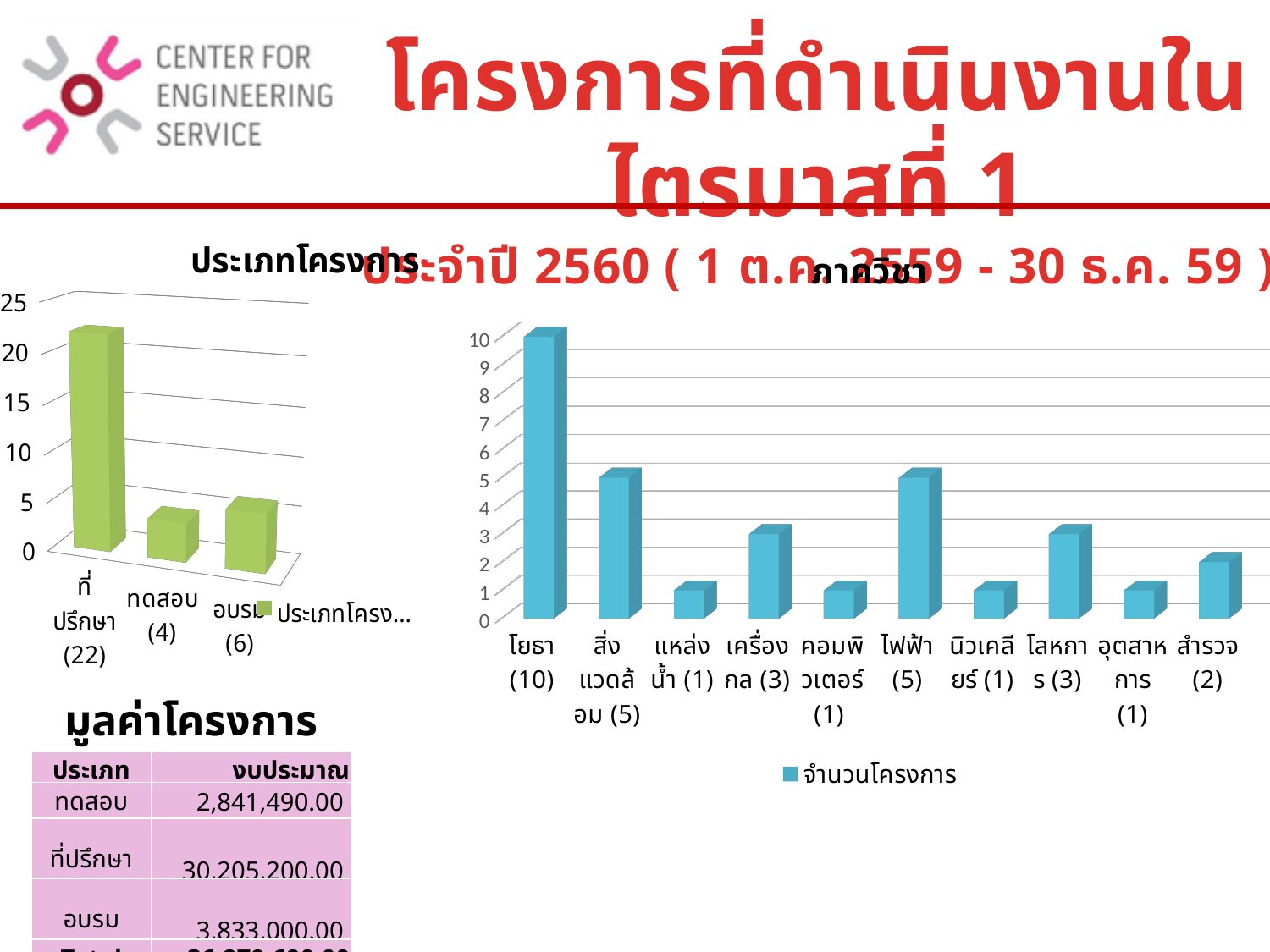
In the ประเภทโครงการ chart, what is the value for ที่ปรึกษา? 22 In the ภาควิชา chart, what series name does the legend show? จำนวนโครงการ In the ภาควิชา chart, how many series does the legend list? 1 In the ภาควิชา chart, what is the difference between the values for โยธา and ไฟฟ้า? 5 In the ประเภทโครงการ chart, what is the difference between the values for ที่ปรึกษา and อบรม? 16 What kind of chart is the ประเภทโครงการ chart? bar chart In the ประเภทโครงการ chart, which category has the lowest value? ทดสอบ In the ภาควิชา chart, which is larger, the value for เครื่องกล or the value for สำรวจ? เครื่องกล In the ภาควิชา chart, which department has the highest number of projects? โยธา In the ภาควิชา chart, how many categories are shown on the x axis? 10 In the ประเภทโครงการ chart, is the value for ที่ปรึกษา greater or less than 20? greater In the ภาควิชา chart, how many projects does โยธา have? 10